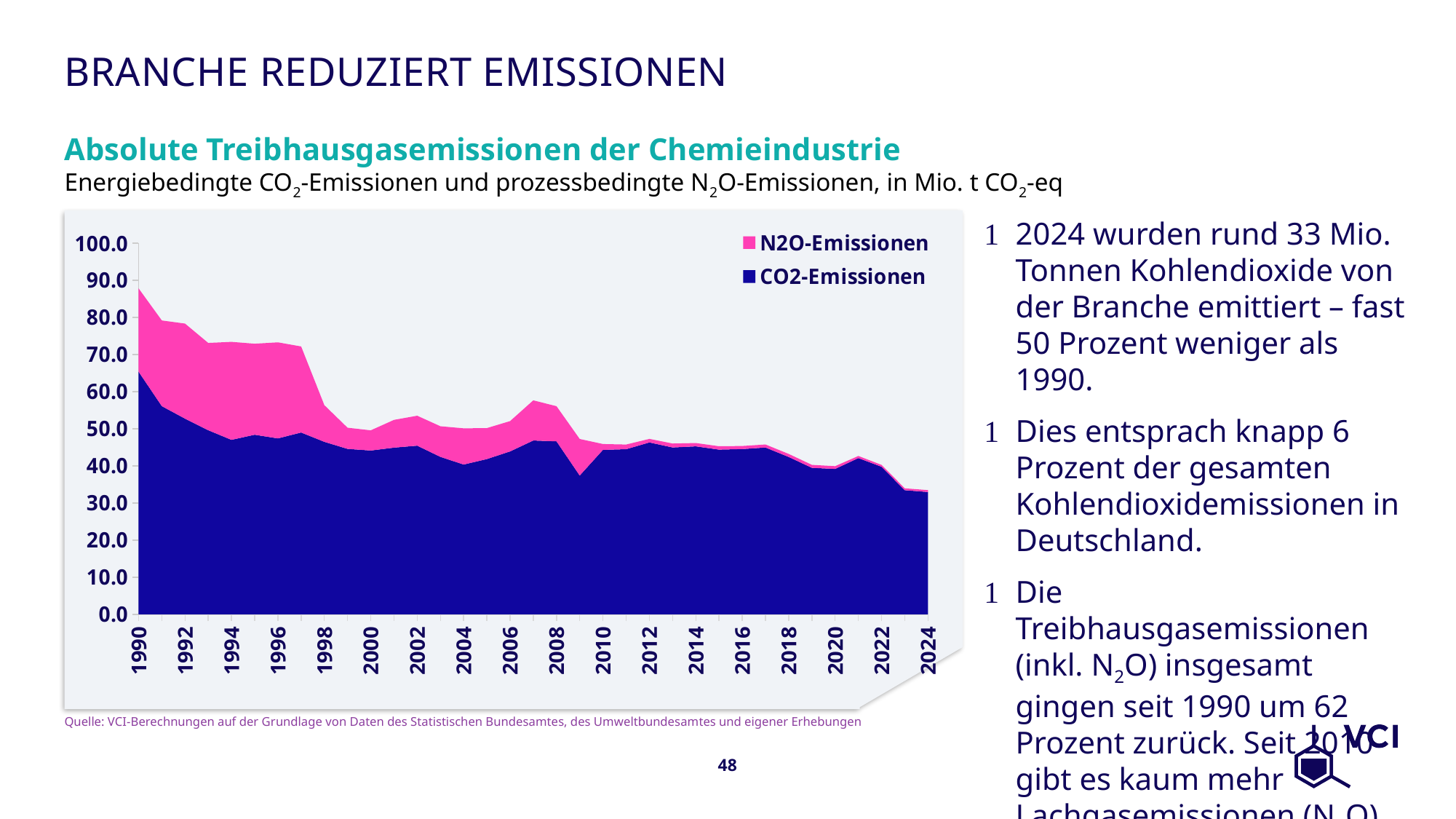
How many series does the chart legend list? 2 In which year are the total emissions (CO2 plus N2O) highest? 1990 Which colour represents the N2O-Emissionen series in the chart? Pink Are the CO2-Emissionen in 2024 greater or less than 40.0? less Which year has larger total emissions, 1990 or 2024? 1990 Are the total emissions in 1990 greater or less than 80.0? greater What kind of chart is shown on the slide? Stacked area chart Are the total emissions in 2007 greater or less than 50.0? greater Do the total emissions in the chart rise or fall from 1990 to 2024? Fall Which two series are listed in the chart legend? N2O-Emissionen and CO2-Emissionen